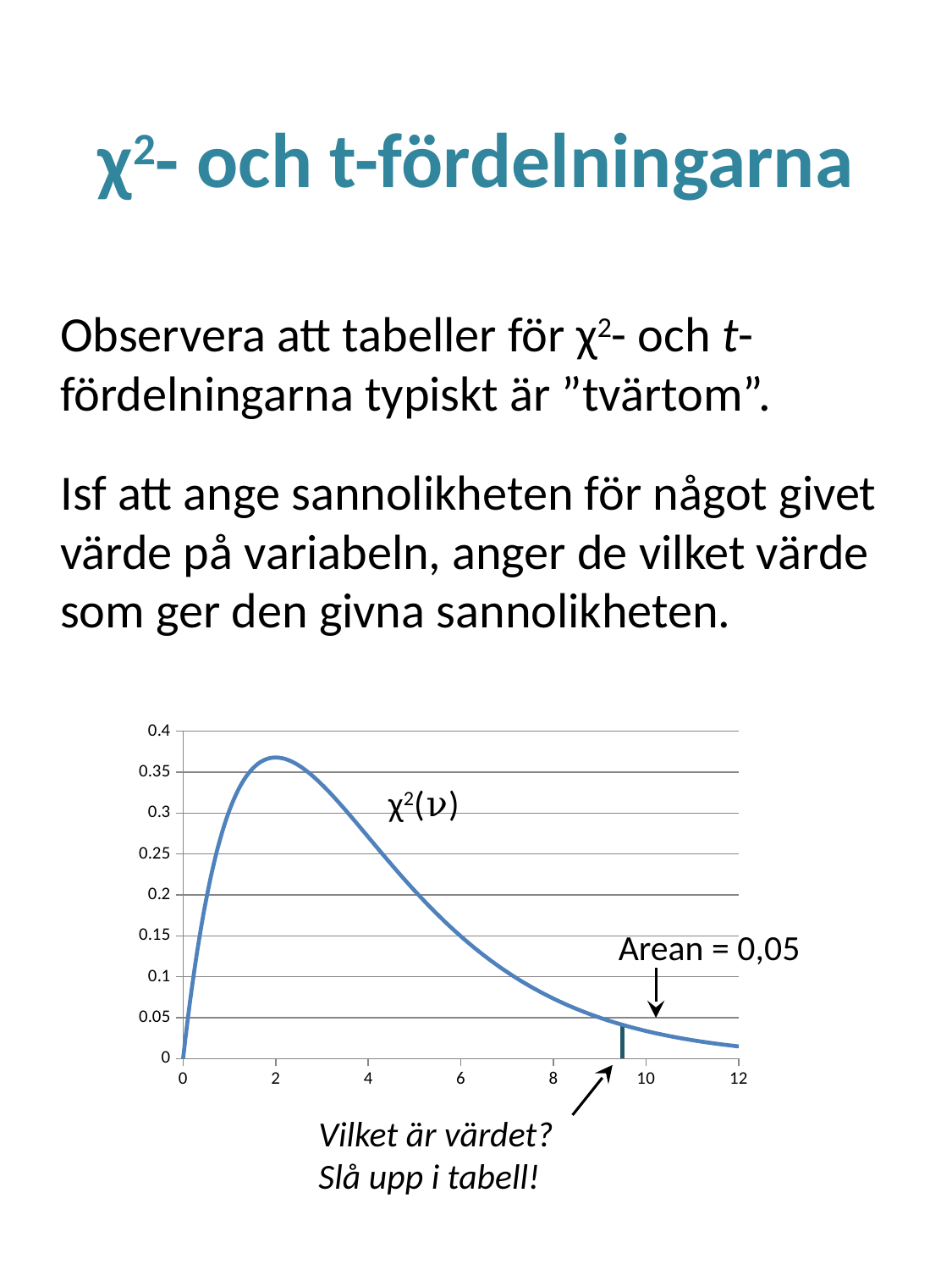
What is the highest tick value shown on the x axis? 12 What does the annotation with the downward arrow near the right tail of the curve say? Arean = 0,05 Is the value of the curve at x = 2 larger or smaller than the value at x = 10? larger What label is written next to the curve in the chart? χ²(ν) After the curve reaches its peak near x = 2, does it rise or fall as x increases? fall Is the value of the curve at x = 4 greater or less than 0.25? greater What kind of chart is shown on the slide? line chart Is the peak value of the curve greater or less than 0.35? greater Between x = 0 and x = 2, does the curve rise or fall? rise Is the value of the curve at x = 8 greater or less than 0.1? less